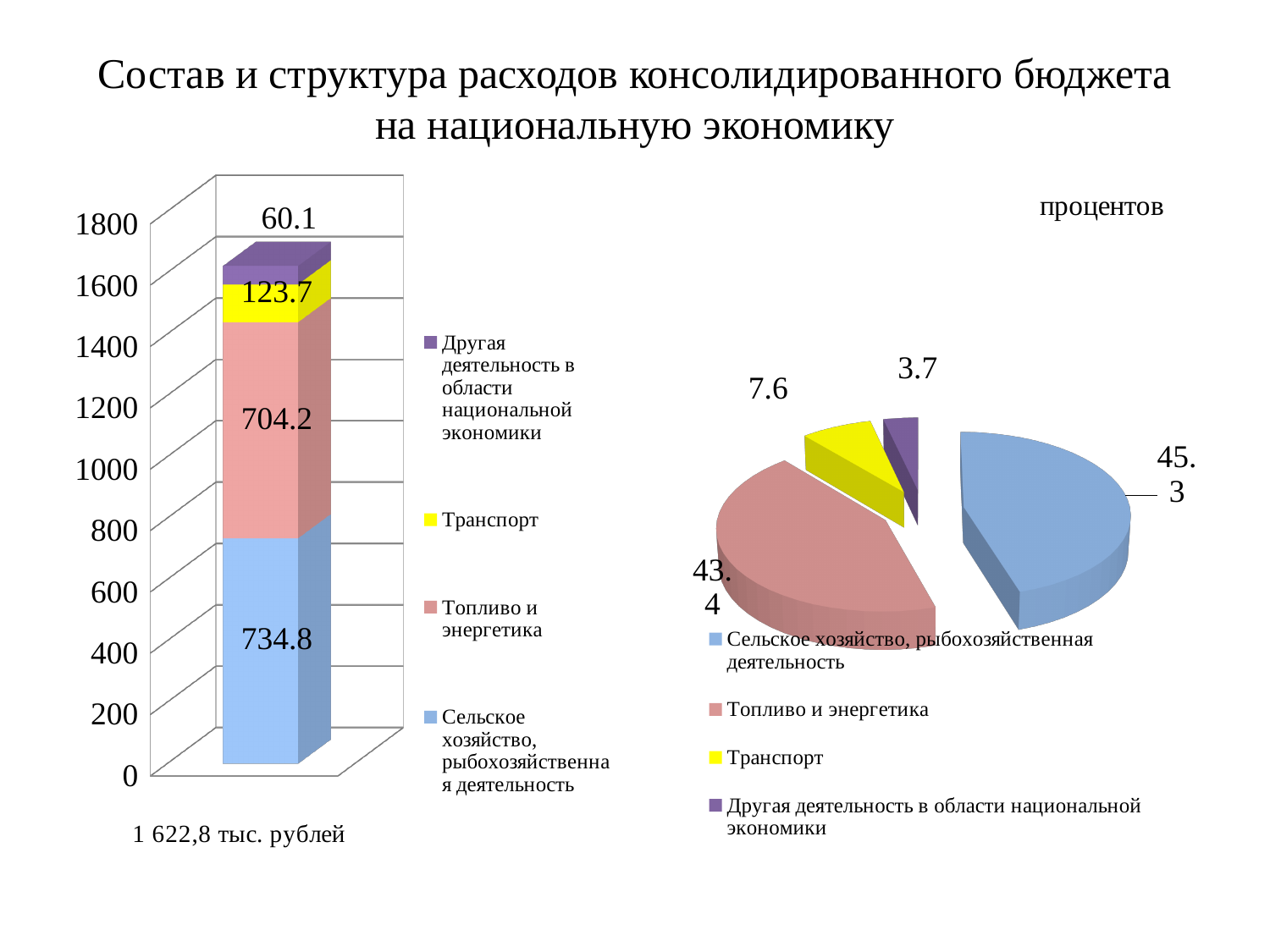
In the right pie chart, which is larger: Транспорт or Другая деятельность в области национальной экономики? Транспорт In the left bar chart, what is the total of the stacked bar? 1622.8 In the right pie chart, what is the value for Транспорт? 7.6 In the left bar chart, what is the value for Транспорт? 123.7 In the left bar chart, what is the difference between Топливо и энергетика and Транспорт? 580.5 In the right pie chart, which slice is the largest? Сельское хозяйство, рыбохозяйственная деятельность How many series does the legend of the left bar chart list? 4 What kind of chart is on the right side of the slide? pie chart In the left bar chart, what is the value for Сельское хозяйство, рыбохозяйственная деятельность? 734.8 In the left bar chart, which segment has the smallest value? Другая деятельность в области национальной экономики What kind of chart is on the left side of the slide? bar chart In the right pie chart, what is the share for Топливо и энергетика? 43.4